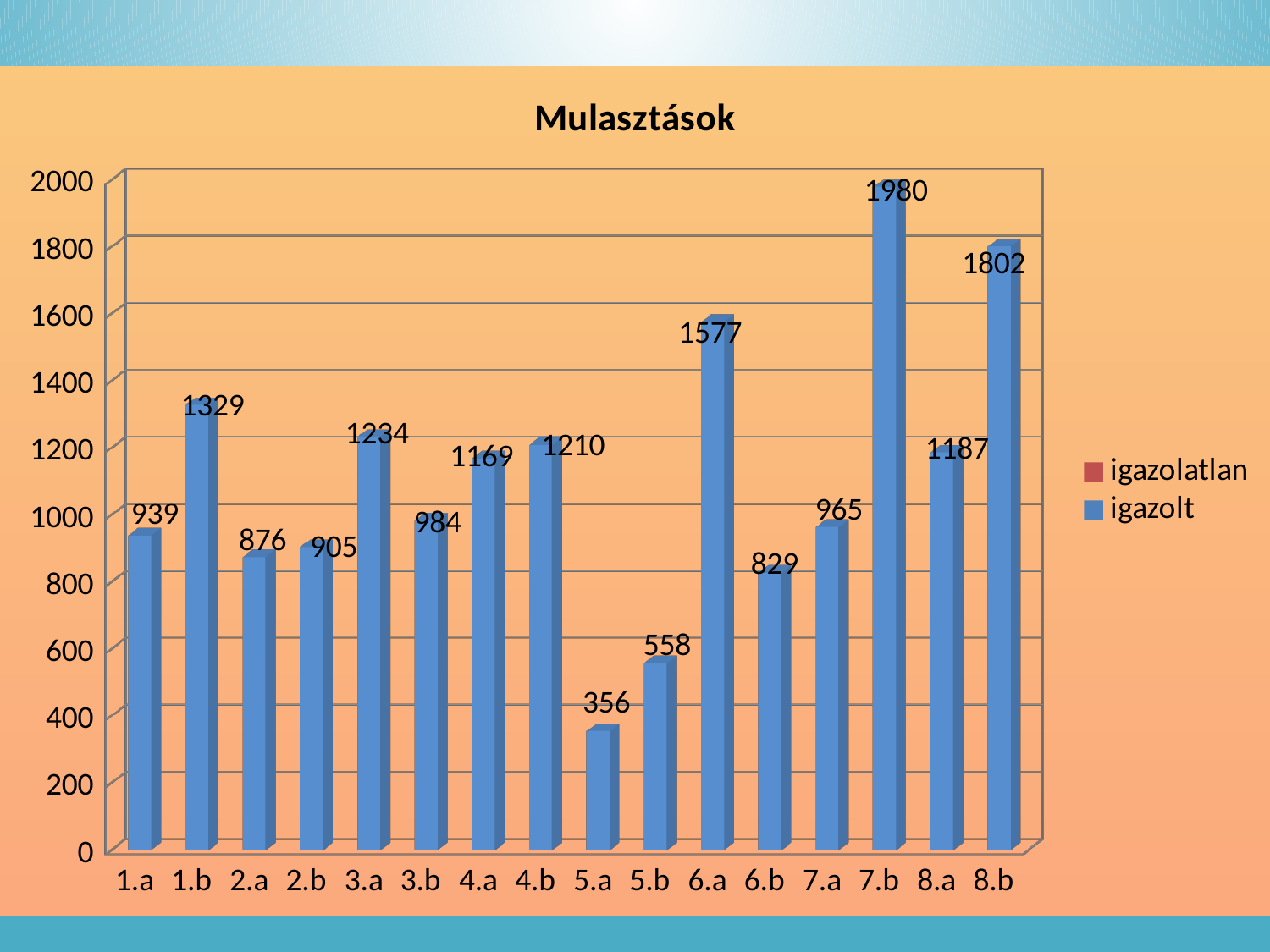
What is the igazolt value for class 3.a? 1234 Which class has the lowest igazolt value? 5.a How many series does the legend list? 2 What is the difference between the igazolt values for 1.b and 1.a? 390 What is the igazolt value for class 7.b? 1980 Which class has a larger igazolt value, 6.a or 8.a? 6.a How many classes are shown on the x axis? 16 What is the difference between the igazolt values for 7.b and 8.b? 178 Is the igazolt value for 6.a greater or less than 1400? greater Which class has the highest igazolt value? 7.b What type of chart is shown? bar chart What is the igazolt value for class 5.b? 558